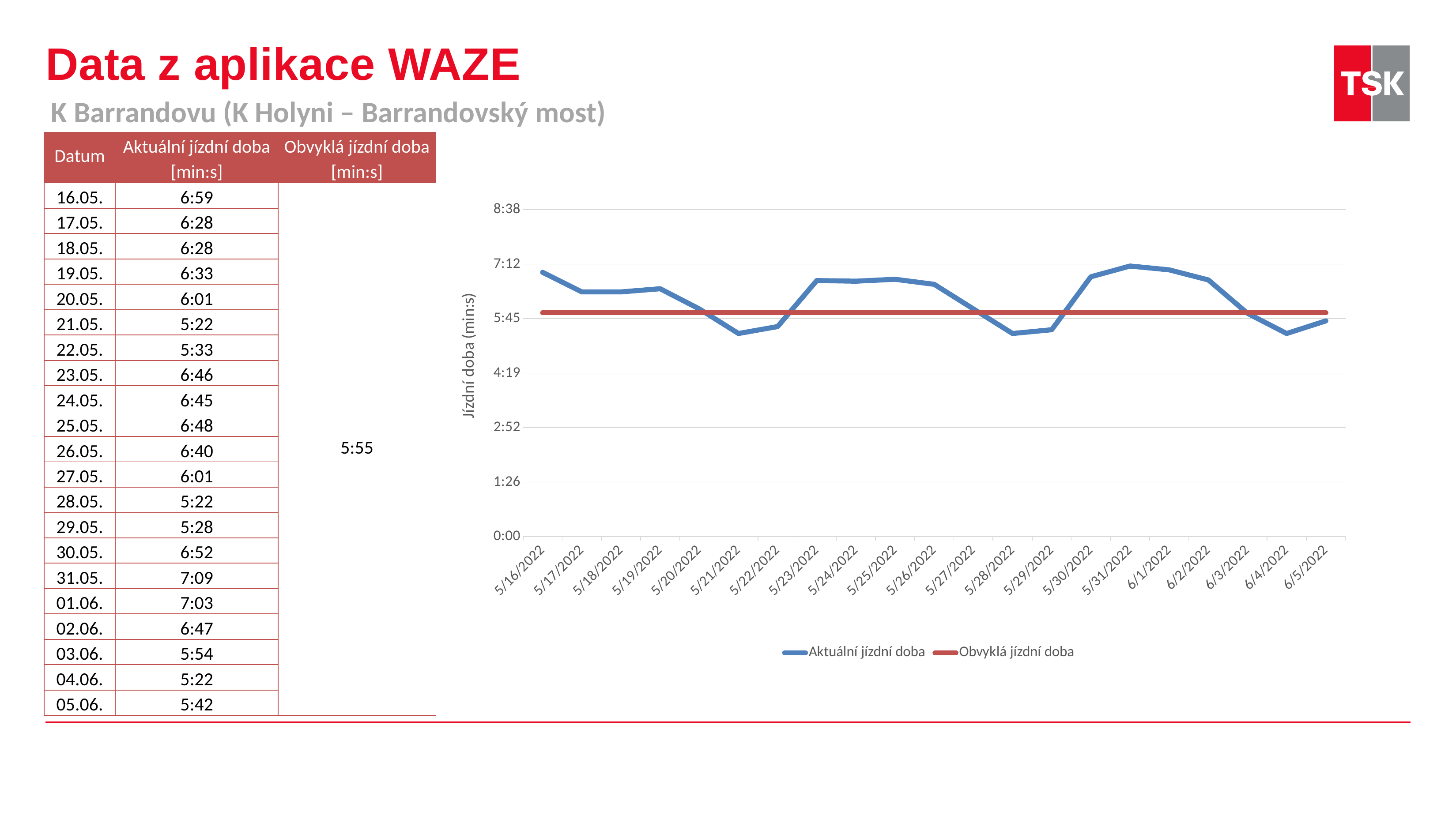
Is the Aktuální jízdní doba value for 5/16/2022 greater or less than 5:45? greater How many dates are plotted along the x axis of the chart? 21 Is the Aktuální jízdní doba value for 5/21/2022 greater or less than 5:45? less What is the difference between the Aktuální jízdní doba on 31.05. and on 21.05., as given on the slide? 1:47 What is the title of the chart's vertical axis? Jízdní doba (min:s) How many series does the chart legend list? 2 Between 5/31/2022 and 6/4/2022, does the Aktuální jízdní doba line rise or fall? fall What is the lowest value of the Aktuální jízdní doba series according to the slide? 5:22 What kind of chart is shown on the slide? line chart Which date has the larger Aktuální jízdní doba value, 5/23/2022 or 5/21/2022? 5/23/2022 On which date does the Aktuální jízdní doba series reach its highest value? 5/31/2022 What is the value of the Obvyklá jízdní doba series shown on the slide? 5:55